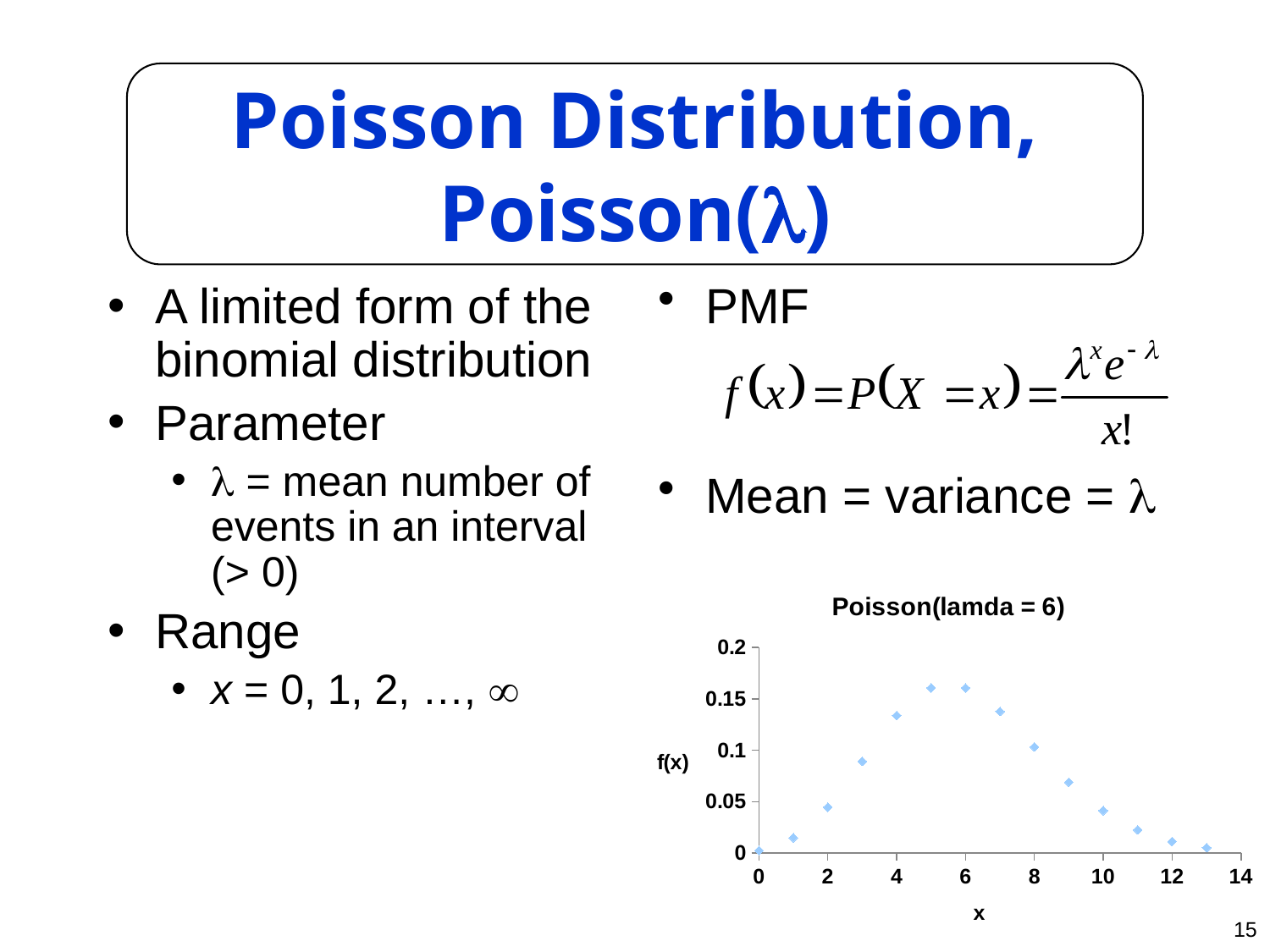
Is the value of f(x) at x = 9 greater or less than 0.05? greater Which has the larger f(x) value, x = 9 or x = 11? x = 9 How many data points are plotted in the chart? 14 What kind of chart is shown on the slide? scatter plot Is the value of f(x) at x = 10 greater or less than 0.05? less What is the title of the chart? Poisson(lamda = 6) What is the label of the vertical axis of the chart? f(x) Is the value of f(x) at x = 4 greater or less than 0.1? greater How do the f(x) values change as x increases from 0 to 13? rise then fall Which has the larger f(x) value, x = 2 or x = 4? x = 4